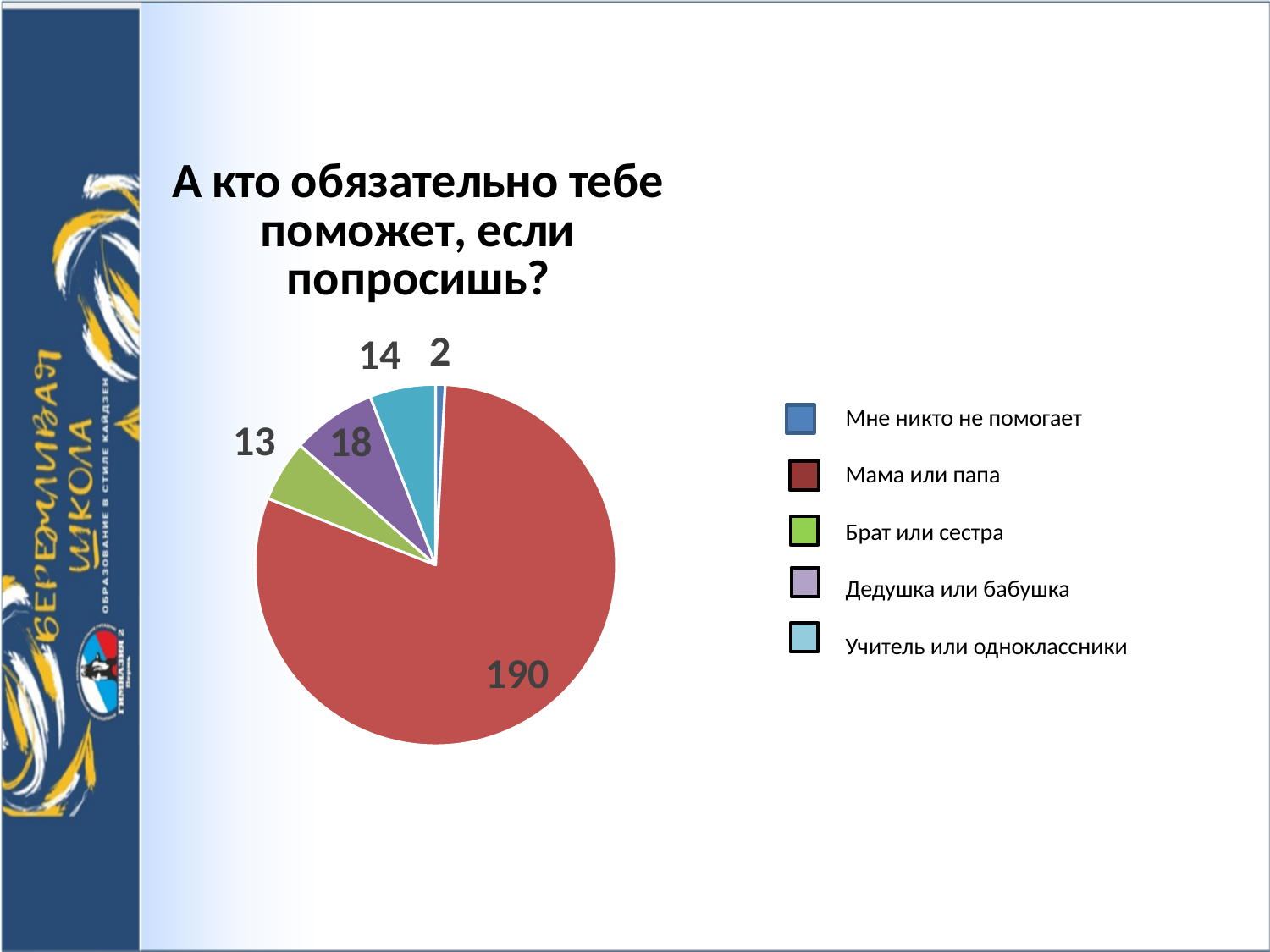
How many entries does the legend list? 5 What is the value for "Дедушка или бабушка"? 18 How many slices does the pie chart have? 5 Which category has the largest slice? Мама или папа Which is larger, the value for "Брат или сестра" or the value for "Учитель или одноклассники"? Учитель или одноклассники What type of chart is shown on the slide? pie chart What is the value for "Мама или папа"? 190 Which category has the smallest slice? Мне никто не помогает What is the value for "Учитель или одноклассники"? 14 What is the value for "Мне никто не помогает"? 2 What is the title of the chart? А кто обязательно тебе поможет, если попросишь? What is the difference between the values for "Мама или папа" and "Дедушка или бабушка"? 172